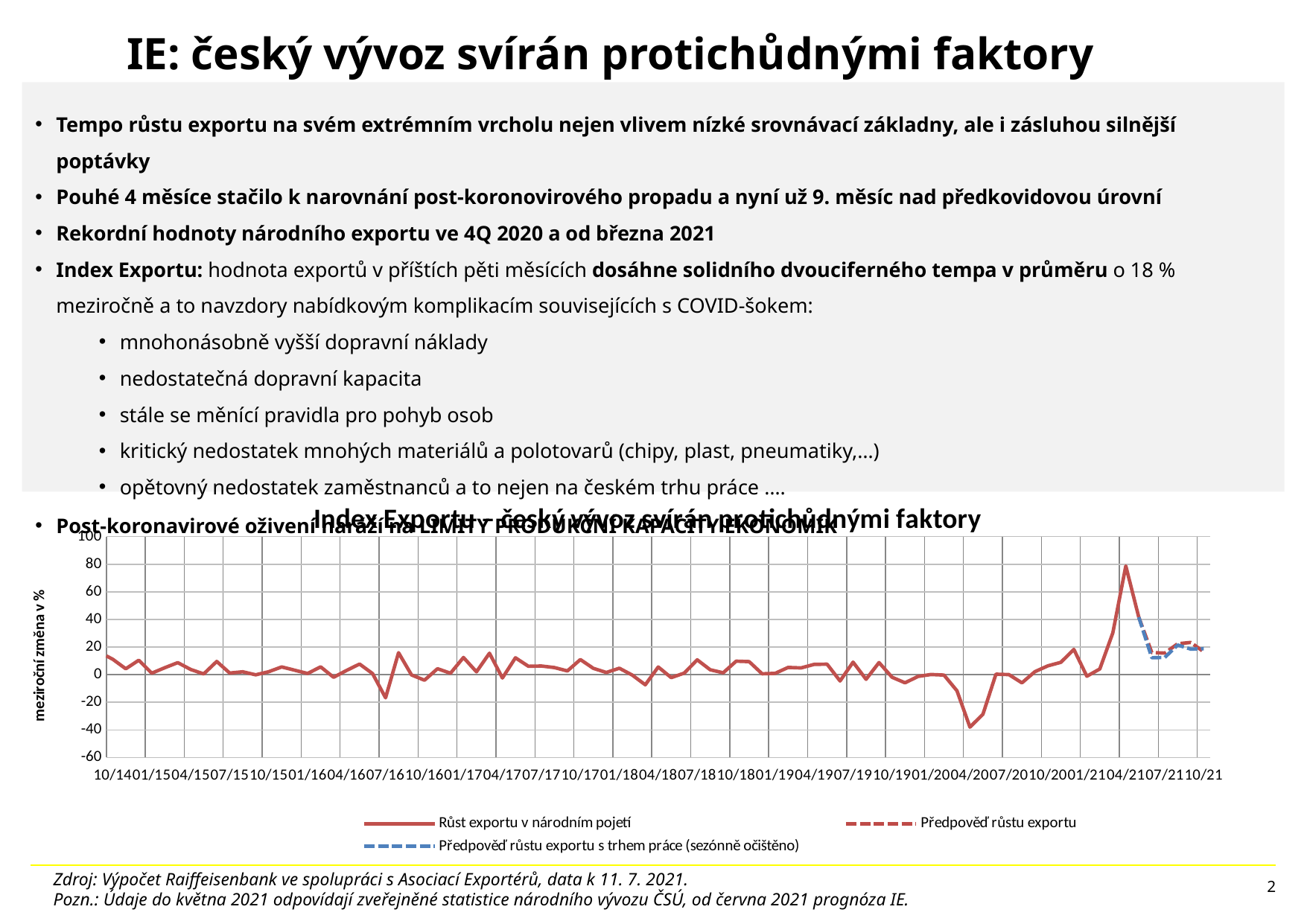
Is the peak of the solid red line in 2021 higher or lower than its peak in 2016? higher Is the lowest value of the solid red line (Růst exportu v národním pojetí) greater or less than -20? less Does the solid red line rise or fall between 01/20 and 04/20? fall What is the title of the chart? Index Exportu – český vývoz svírán protichůdnými faktory Is the highest value of the solid red line (Růst exportu v národním pojetí) greater or less than 60? greater How many series does the chart legend list? 3 Does the solid red line rise or fall between 04/20 and 04/21? rise Is the value of Růst exportu v národním pojetí at 10/14 greater or less than 0? greater Which series is drawn as a blue dashed line? Předpověď růstu exportu s trhem práce (sezónně očištěno) What kind of chart is shown on the slide? line chart